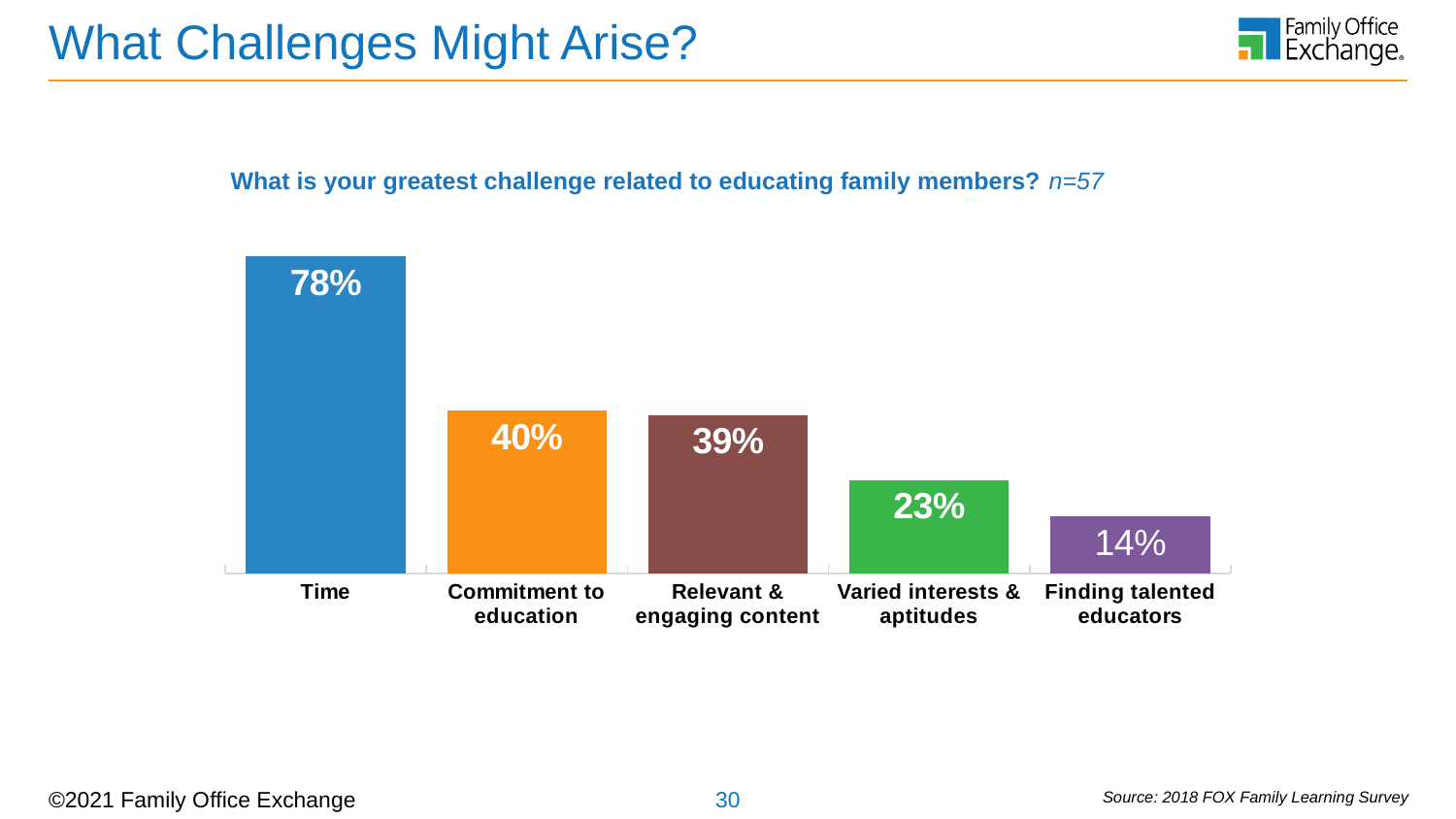
What is the value for Finding talented educators? 14% What is the difference between the values for Time and Commitment to education? 38% What percentage of respondents cited Time as their greatest challenge? 78% Which is larger, the value for Varied interests & aptitudes or the value for Finding talented educators? Varied interests & aptitudes What is the value for Commitment to education? 40% Which challenge has the highest percentage? Time What is the difference between the values for Relevant & engaging content and Finding talented educators? 25% What is the value for Varied interests & aptitudes? 23% How many challenge categories are shown in the chart? 5 Which challenge has the lowest percentage? Finding talented educators Do the values rise or fall from left to right across the categories? Fall What kind of chart is shown on the slide? Bar chart